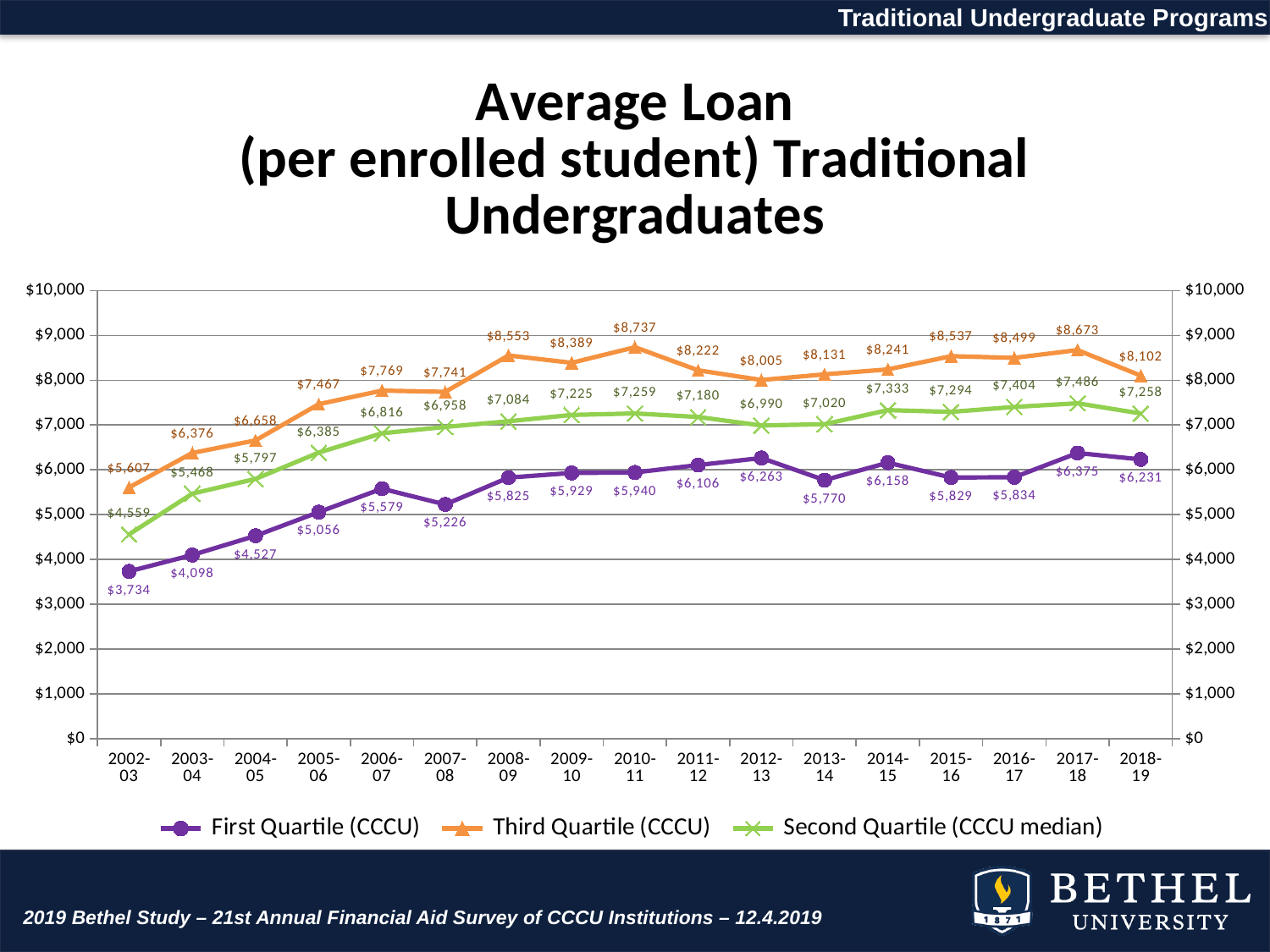
Is the Third Quartile (CCCU) value for 2008-09 greater or less than $8,000? greater How many series does the legend list? 3 What is the Second Quartile (CCCU median) value for 2018-19? $7,258 What is the First Quartile (CCCU) value for 2002-03? $3,734 What is the Third Quartile (CCCU) value for 2010-11? $8,737 What kind of chart is shown on the slide? Line chart In which year is the First Quartile (CCCU) value lowest? 2002-03 In which year does the Third Quartile (CCCU) series reach its highest value? 2010-11 Which is larger in 2007-08: the First Quartile (CCCU) value or the Second Quartile (CCCU median) value? Second Quartile (CCCU median) How many academic years are plotted on the x axis? 17 What is the difference between the Third Quartile (CCCU) and First Quartile (CCCU) values in 2018-19? $1,871 In which year does the Second Quartile (CCCU median) series reach its highest value? 2017-18